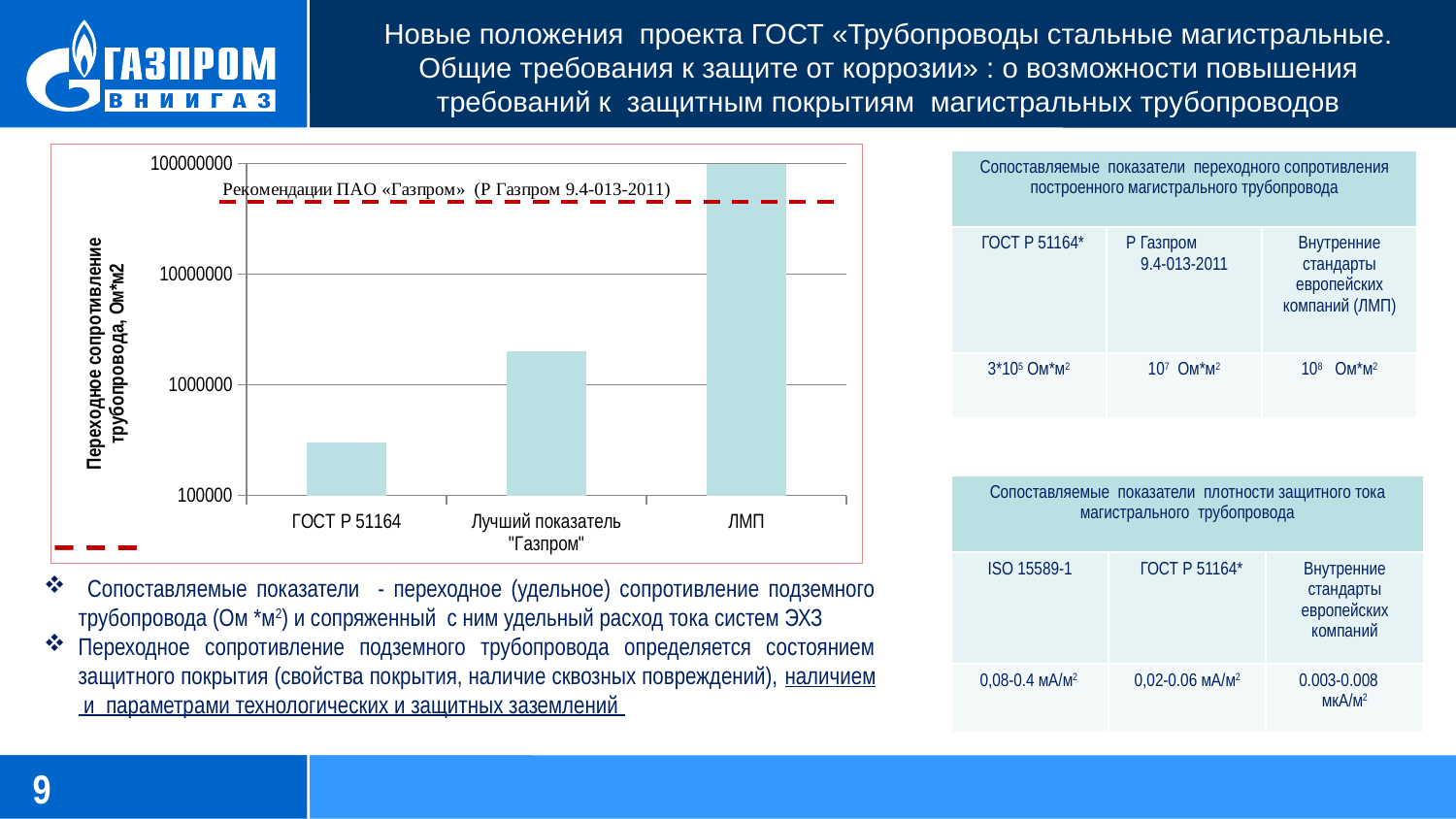
Which category has the highest value in the chart? ЛМП What kind of chart is shown on the slide? bar chart Which is larger, the value for ГОСТ Р 51164 or the value for Лучший показатель "Газпром"? Лучший показатель "Газпром" What is the label of the y axis of the chart? Переходное сопротивление трубопровода, Ом*м2 Is the value for Лучший показатель "Газпром" greater or less than 10000000? less What value does the bar for ЛМП reach on the y axis? 100000000 Is the value for Лучший показатель "Газпром" greater or less than 1000000? greater Do the bar values rise or fall from left to right along the x axis? rise What does the red dashed horizontal line on the chart represent? Рекомендации ПАО «Газпром» (Р Газпром 9.4-013-2011) Is the value for ГОСТ Р 51164 greater or less than 1000000? less How many categories are shown on the x axis of the chart? 3 Which category has the lowest value in the chart? ГОСТ Р 51164